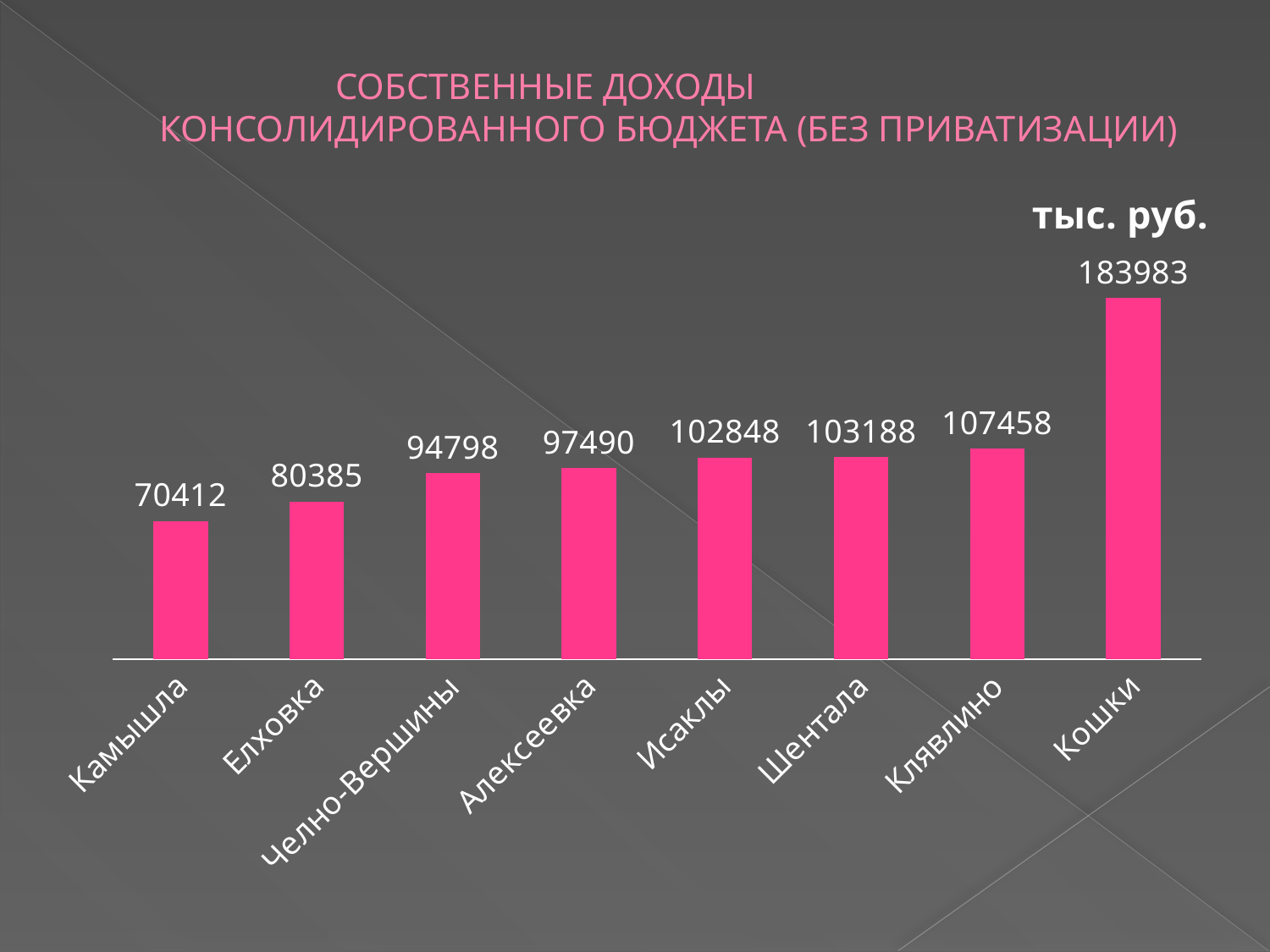
What is the difference between the values for Кошки and Камышла? 113571 Which category has the lowest value? Камышла Do the values rise or fall from left to right along the x axis? Rise What is the value for Камышла? 70412 Which category has the highest value? Кошки What is the value for Челно-Вершины? 94798 What kind of chart is shown on the slide? Bar chart Which is larger, the value for Алексеевка or the value for Исаклы? Исаклы What is the value for Клявлино? 107458 How many categories are shown on the chart? 8 What is the difference between the values for Клявлино and Елховка? 27073 What unit is indicated for the values on the chart? тыс. руб.